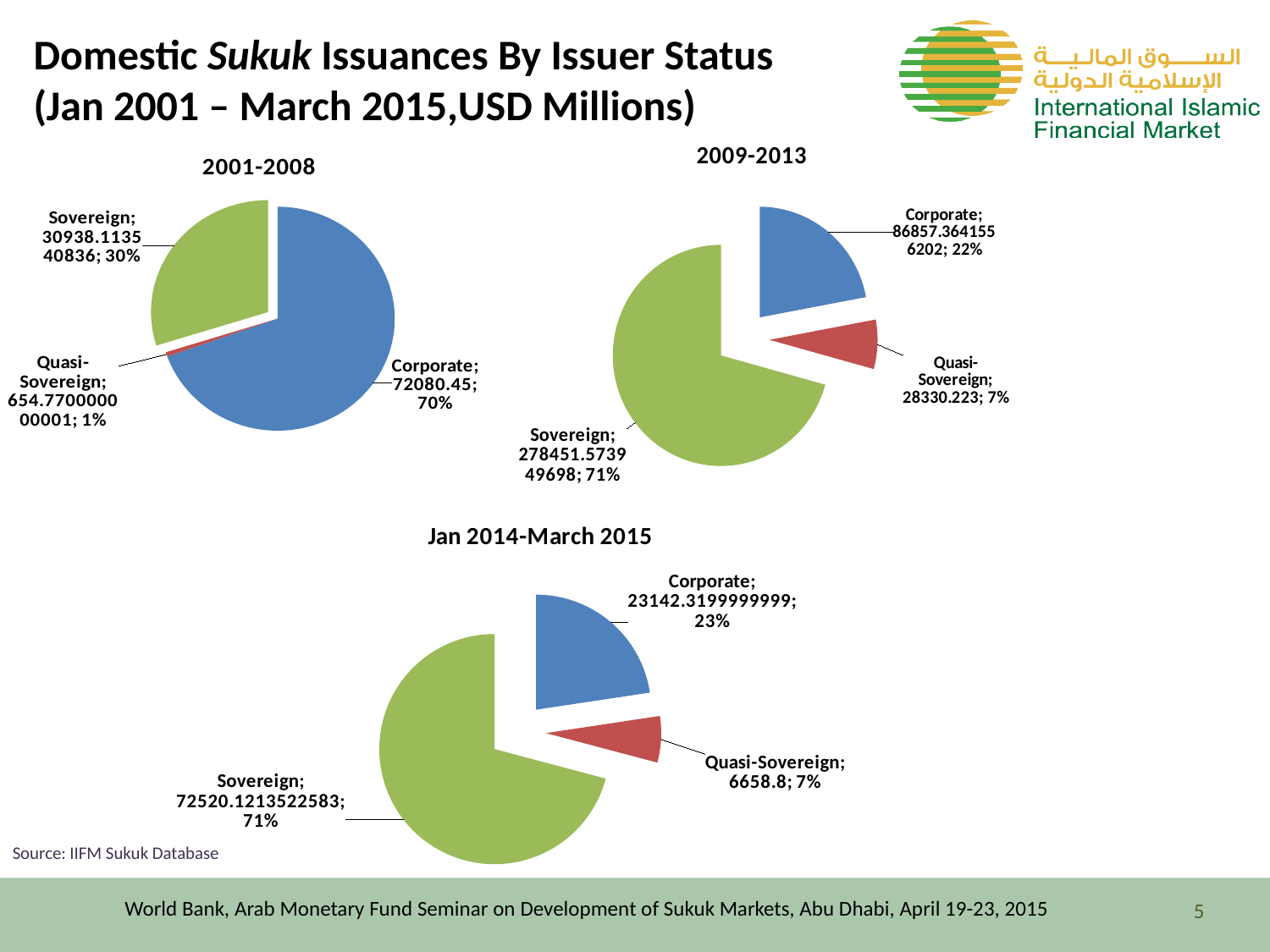
In the Jan 2014-March 2015 chart, what is the value for Quasi-Sovereign? 6658.8 In the 2009-2013 chart, what share of the pie does Corporate represent? 22% How many pie charts are shown on the slide? 3 In the Jan 2014-March 2015 chart, which is larger, Corporate or Quasi-Sovereign? Corporate In the 2001-2008 chart, which issuer status has the smallest slice? Quasi-Sovereign What type of chart is used for the 2001-2008 data? pie chart In the 2009-2013 chart, which issuer status has the largest slice? Sovereign In the 2001-2008 chart, what is the value for Corporate? 72080.45 In the 2001-2008 chart, what share of the pie does Sovereign represent? 30% In the 2009-2013 chart, what is the value for Quasi-Sovereign? 28330.223 In the Jan 2014-March 2015 chart, what share of the pie does Sovereign represent? 71% How many slices does the Jan 2014-March 2015 pie chart have? 3